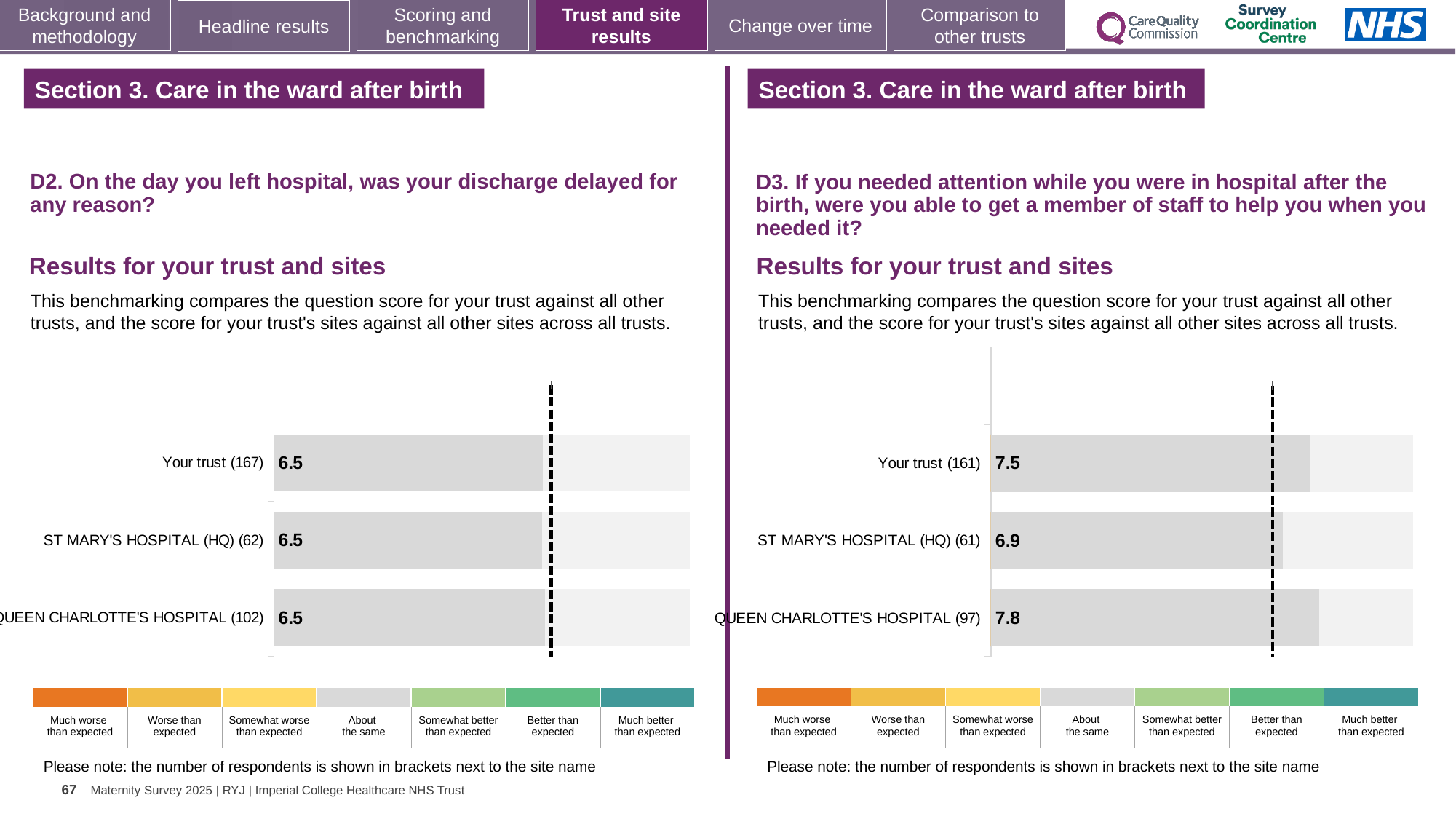
In the D3 chart on the right, what is the difference between the scores for QUEEN CHARLOTTE'S HOSPITAL (97) and ST MARY'S HOSPITAL (HQ) (61)? 0.9 In the D2 chart on the left, what is the score for QUEEN CHARLOTTE'S HOSPITAL (102)? 6.5 What kind of chart is used in the D3 chart on the right? Bar chart How many bars are shown in the D2 chart on the left? 3 In the D3 chart on the right, what is the score for ST MARY'S HOSPITAL (HQ) (61)? 6.9 How many benchmark categories does the colour key below the D2 chart on the left list? 7 In the D2 chart on the left, what is the score for Your trust (167)? 6.5 In the D3 chart on the right, which has the larger score: Your trust (161) or ST MARY'S HOSPITAL (HQ) (61)? Your trust (161) In the D3 chart on the right, what is the score for QUEEN CHARLOTTE'S HOSPITAL (97)? 7.8 In the D3 chart on the right, what is the score for Your trust (161)? 7.5 In the D3 chart on the right, which site or trust has the highest score? QUEEN CHARLOTTE'S HOSPITAL (97) In the D3 chart on the right, which site or trust has the lowest score? ST MARY'S HOSPITAL (HQ) (61)